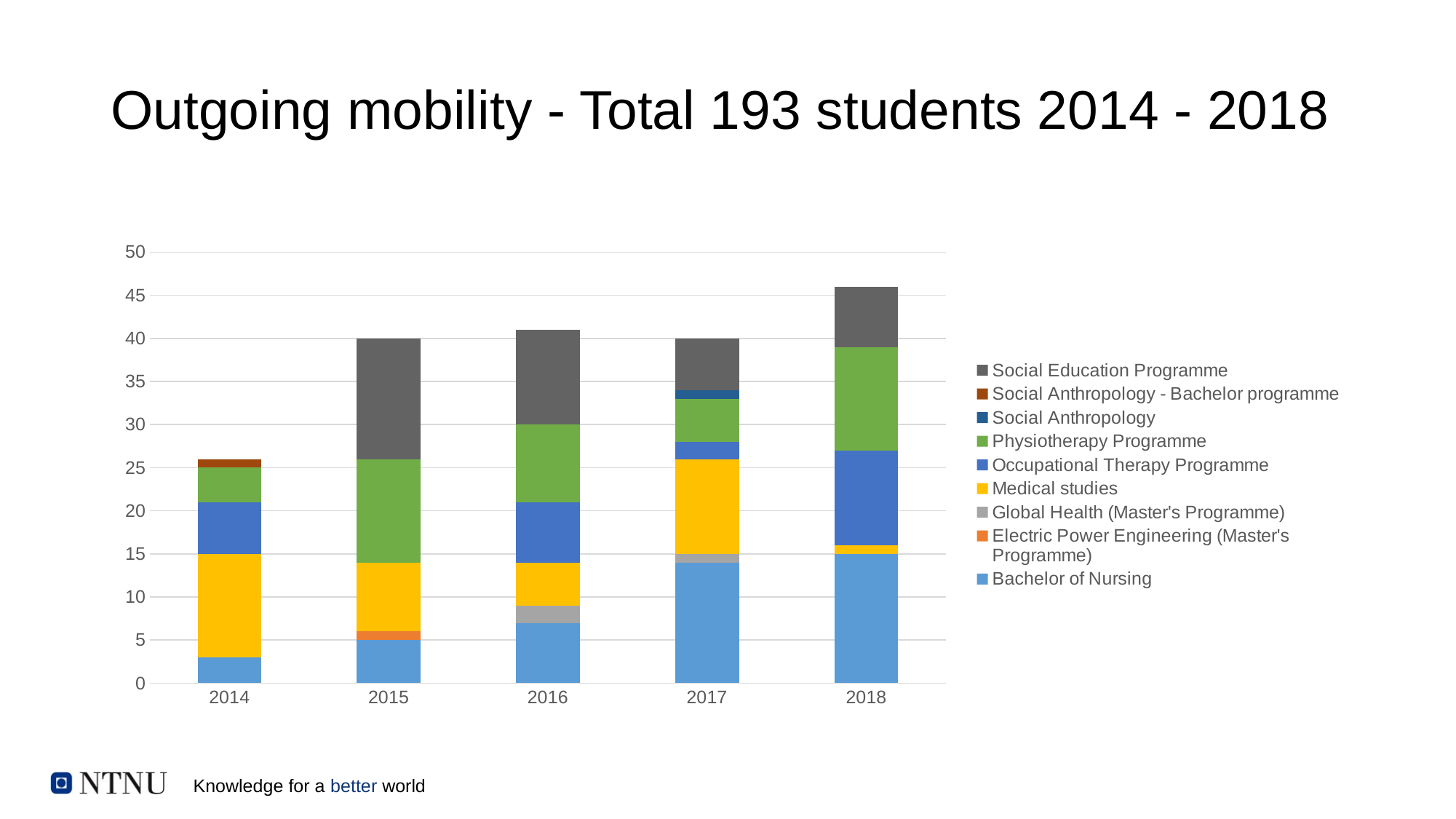
How many series does the chart's legend list? 9 Is the total stacked bar for 2018 larger or smaller than the total for 2014? larger Which year has the tallest stacked bar in the chart? 2018 What is the value for Bachelor of Nursing in 2018? 15 What is the title of the slide containing the chart? Outgoing mobility - Total 193 students 2014 - 2018 Is the total for 2018 greater or less than 45? greater What is the total height of the stacked bar for 2015? 40 What kind of chart is shown on the slide? Stacked bar chart Is the total for 2014 greater or less than 30? less What is the total height of the stacked bar for 2017? 40 Which year has the shortest stacked bar in the chart? 2014 How many years are shown on the x axis of the chart? 5